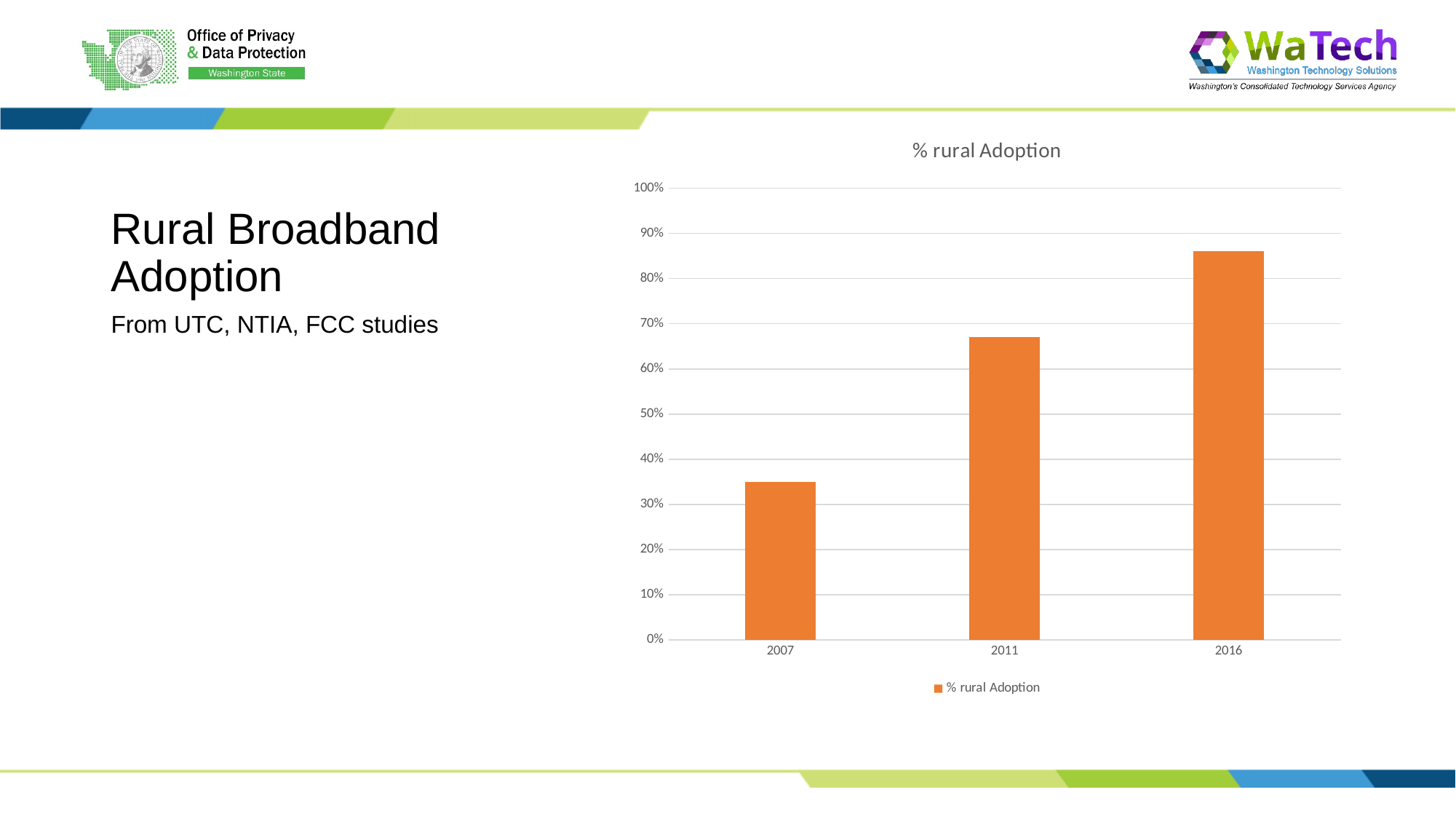
Which year has the lowest % rural Adoption? 2007 Is the value for 2016 greater or less than 90%? less What is the title of the chart? % rural Adoption Do the values rise or fall from 2007 to 2016? rise Which year has the highest % rural Adoption? 2016 Is the value for 2011 greater or less than 60%? greater How many years (categories) are plotted on the chart? 3 How many series does the legend list? 1 What type of chart is shown on the slide? bar chart Is the value for 2007 greater or less than 40%? less Which is larger, the value for 2011 or the value for 2016? 2016